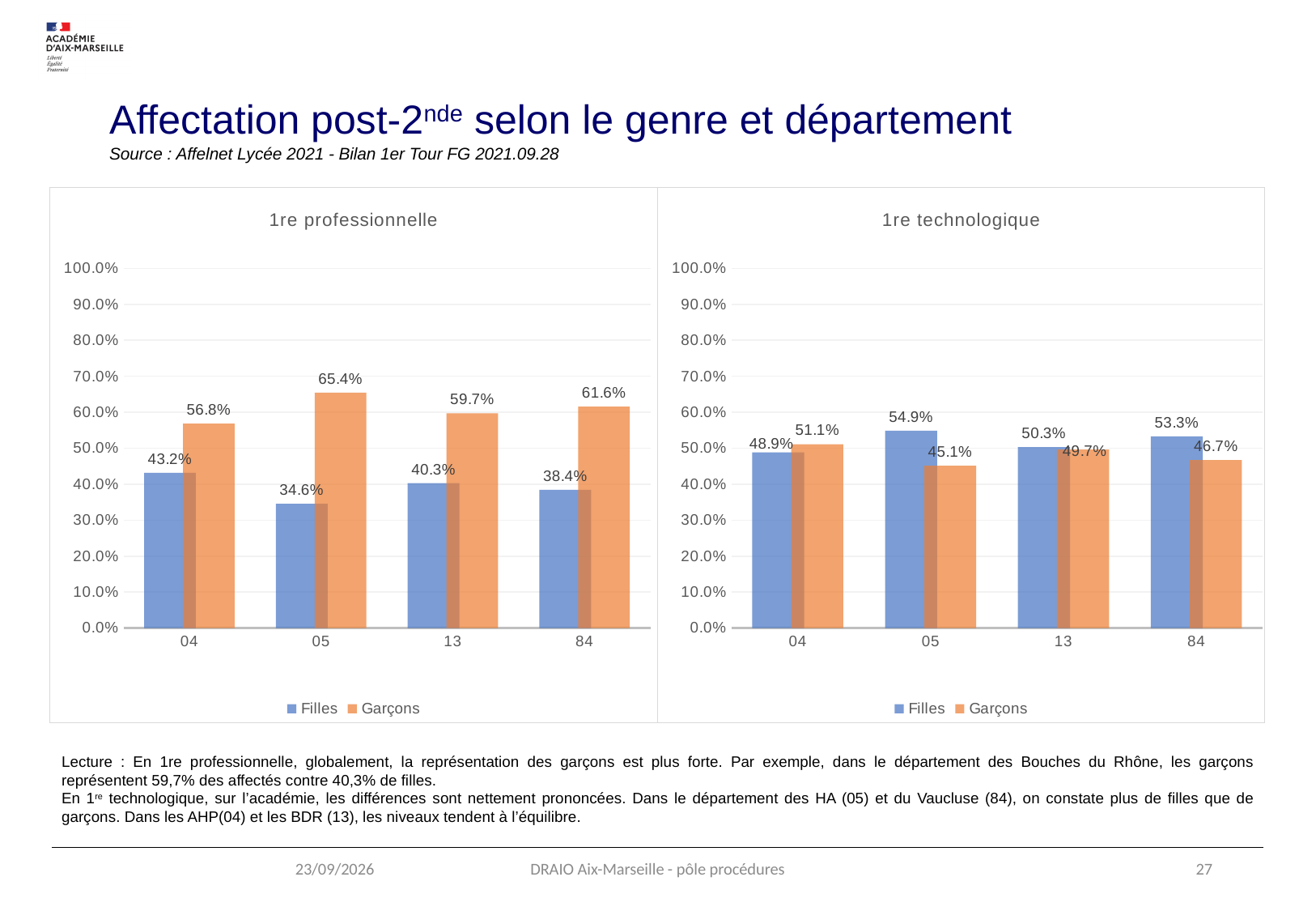
In the '1re technologique' chart, which is larger in department 05, Filles or Garçons? Filles In the '1re professionnelle' chart, what is the difference between Garçons and Filles in department 84? 23.2% In the '1re technologique' chart, what is the value for Garçons in department 04? 51.1% How many series does the legend of the '1re professionnelle' chart list? 2 In the '1re professionnelle' chart, what is the value for Filles in department 13? 40.3% In the '1re professionnelle' chart, what is the value for Garçons in department 05? 65.4% In the '1re professionnelle' chart, is the value for Garçons in department 13 greater or less than 50.0%? greater In the '1re technologique' chart, what is the value for Filles in department 84? 53.3% In the '1re professionnelle' chart, which department has the lowest value for Filles? 05 In the '1re technologique' chart, which department has the highest value for Filles? 05 How many departments are shown on the x axis of the '1re technologique' chart? 4 What kind of chart is the '1re technologique' chart? Bar chart